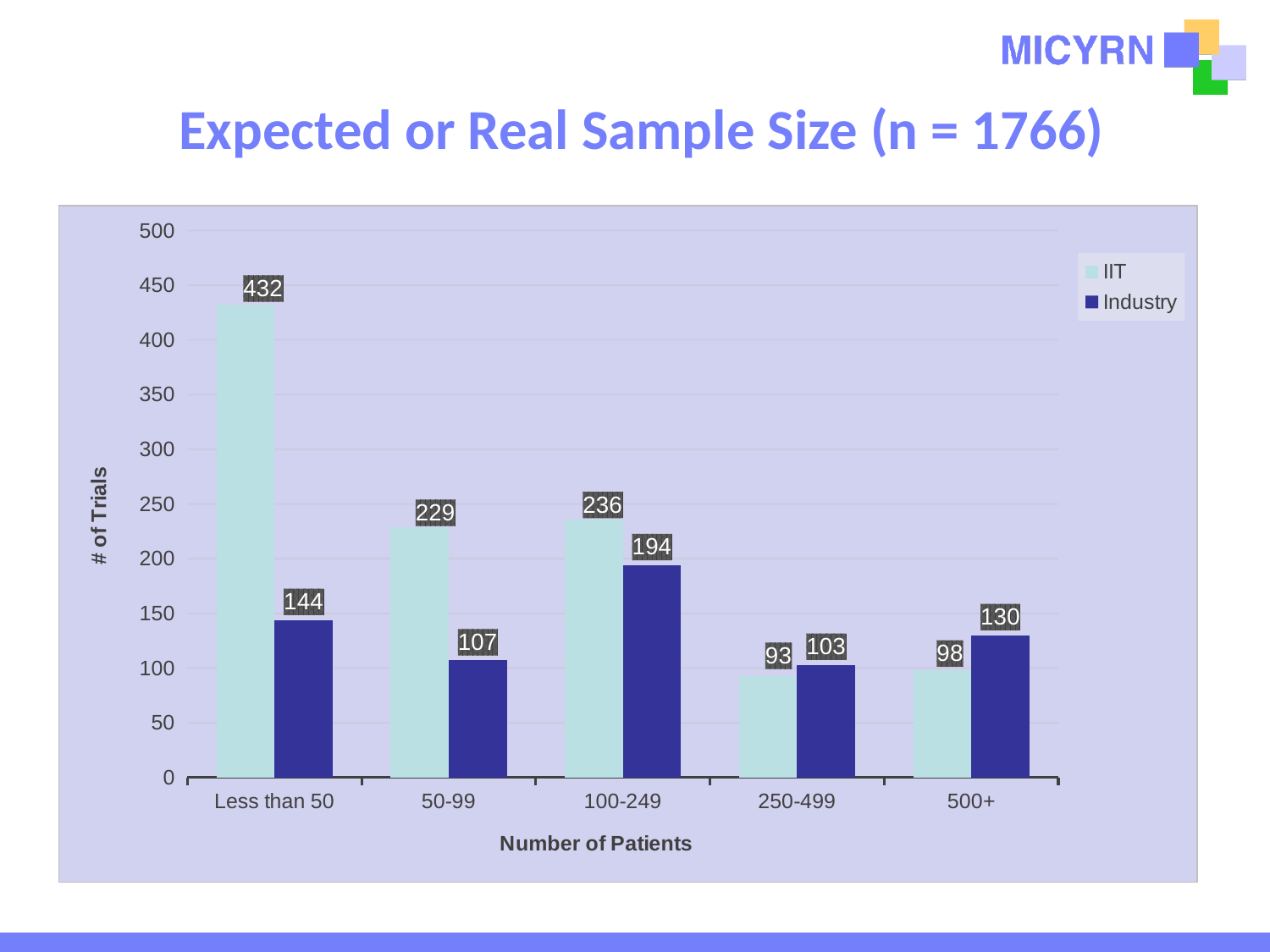
What is the IIT value for the 'Less than 50' category? 432 What is the IIT value for the '500+' category? 98 Which category has the lowest Industry value? 250-499 What is the difference between the IIT and Industry values for the '50-99' category? 122 Which category has the highest IIT value? Less than 50 How many categories are shown on the x axis? 5 How many series does the legend list? 2 What is the title of the chart? Expected or Real Sample Size (n = 1766) For the '500+' category, which series has the larger value, IIT or Industry? Industry What is the label of the y axis? # of Trials What is the Industry value for the '100-249' category? 194 What kind of chart is shown on the slide? Bar chart